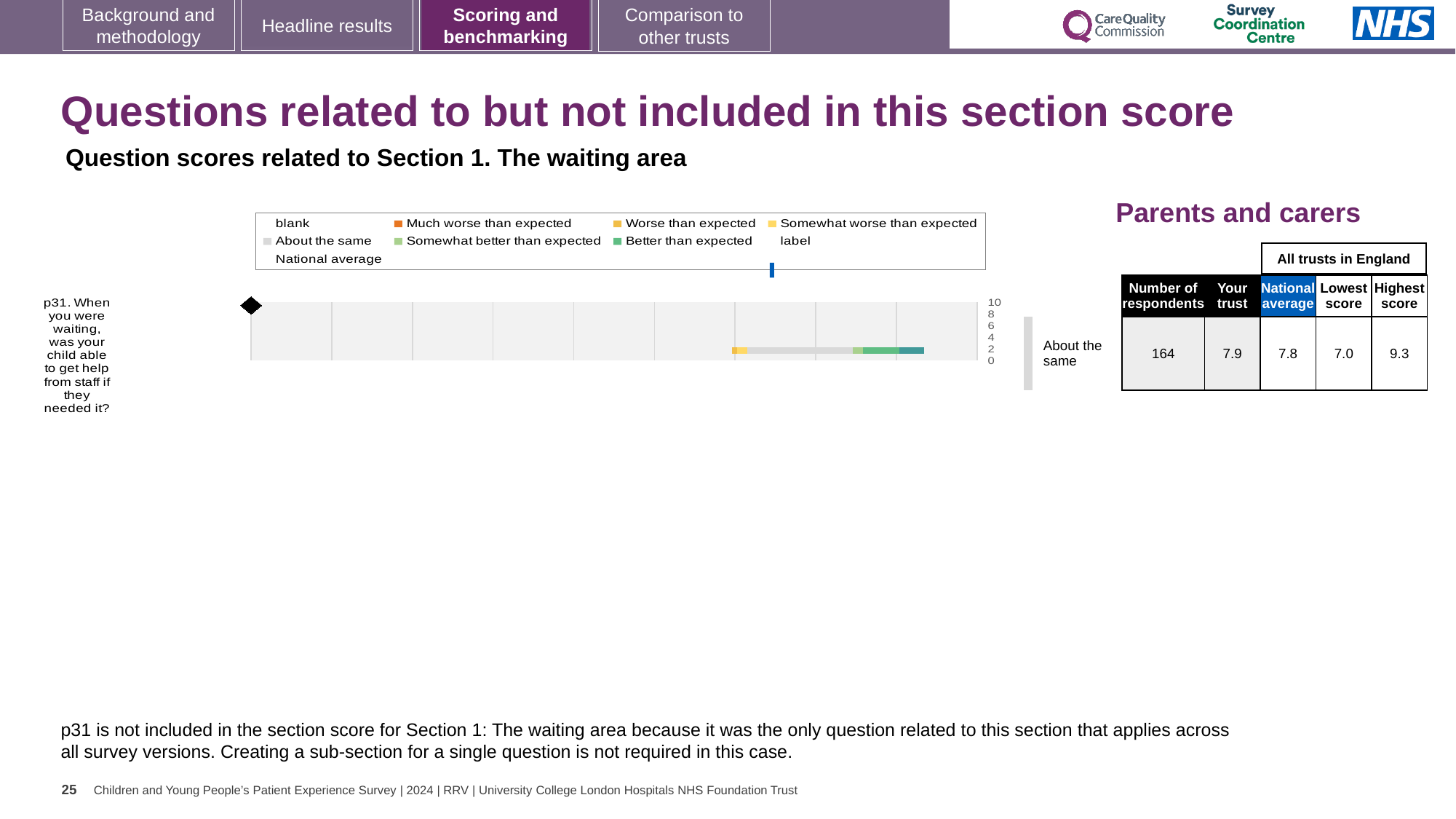
In the Parents and carers table, what is the Lowest score across all trusts in England for p31? 7.0 What is the highest value shown on the chart's score axis? 10 In the Parents and carers table, which is larger for p31: the Your trust score or the National average? Your trust What kind of chart is used to show the p31 result on this slide? bar chart In the Parents and carers table, what is the National average score for p31? 7.8 What benchmark category label is shown to the right of the p31 bar? About the same In the Parents and carers table, what is the Your trust score for p31? 7.9 Which question number is plotted in the chart on this slide? p31 How many survey questions are plotted in the chart on this slide? 1 In the Parents and carers table, what is the difference between the Highest score and the Lowest score for p31? 2.3 In the Parents and carers table, what is the Highest score across all trusts in England for p31? 9.3 In the Parents and carers table, what is the Number of respondents for p31? 164